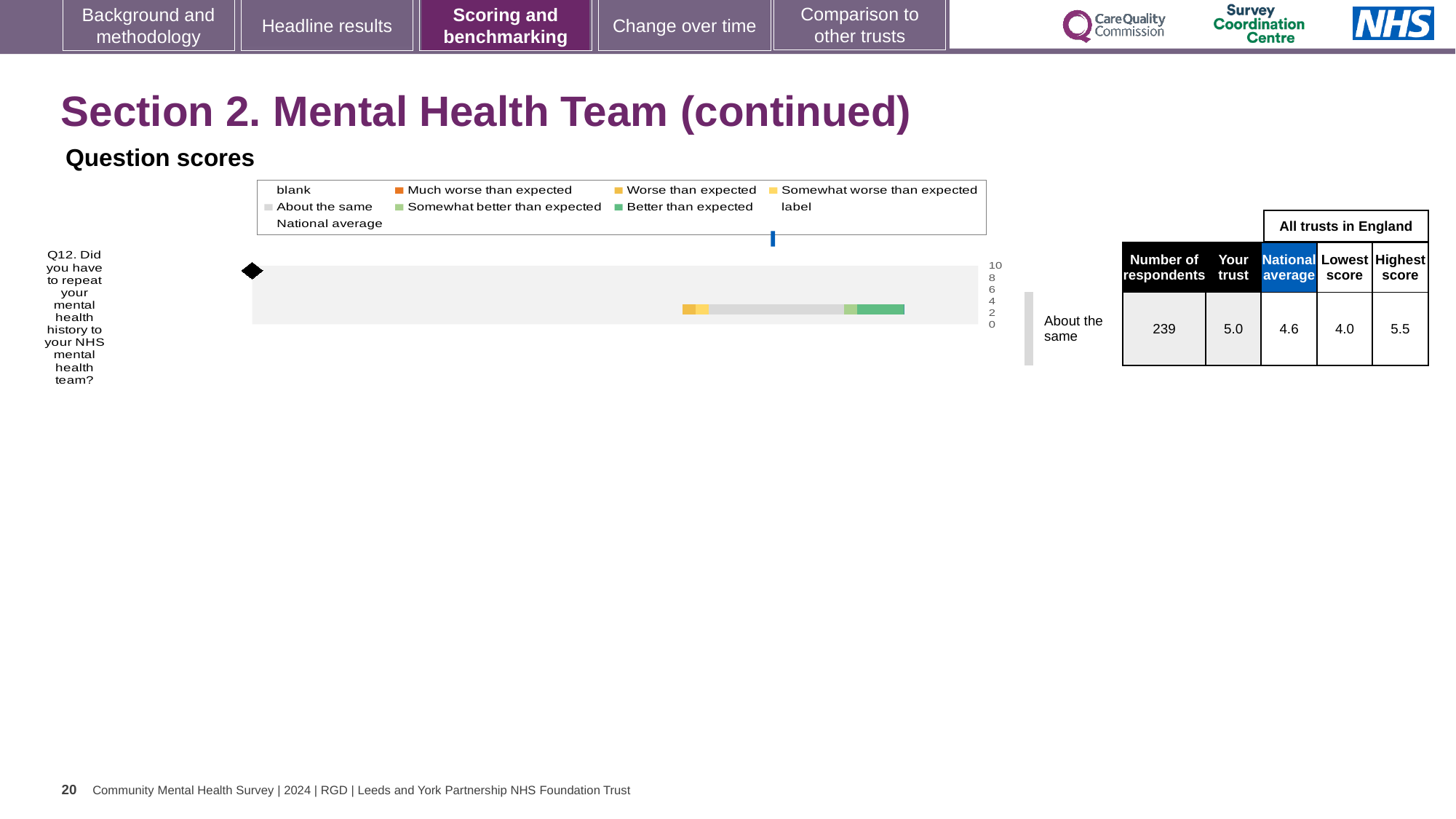
By how much does the trust's Q12 score exceed the national average? 0.4 How many survey questions are plotted on the chart? 1 What is the national average score for Q12? 4.6 What is the 'Your trust' score for Q12 (repeating mental health history to the NHS mental health team)? 5.0 What is the difference between the highest and lowest trust scores for Q12? 1.5 How many respondents answered Q12? 239 What is the highest score among all trusts in England for Q12? 5.5 What kind of chart is used to show the Q12 score? bar chart What is the lowest score among all trusts in England for Q12? 4.0 Which is larger for Q12: the trust's score or the national average? Your trust Which benchmark category is the trust's Q12 result placed in? About the same